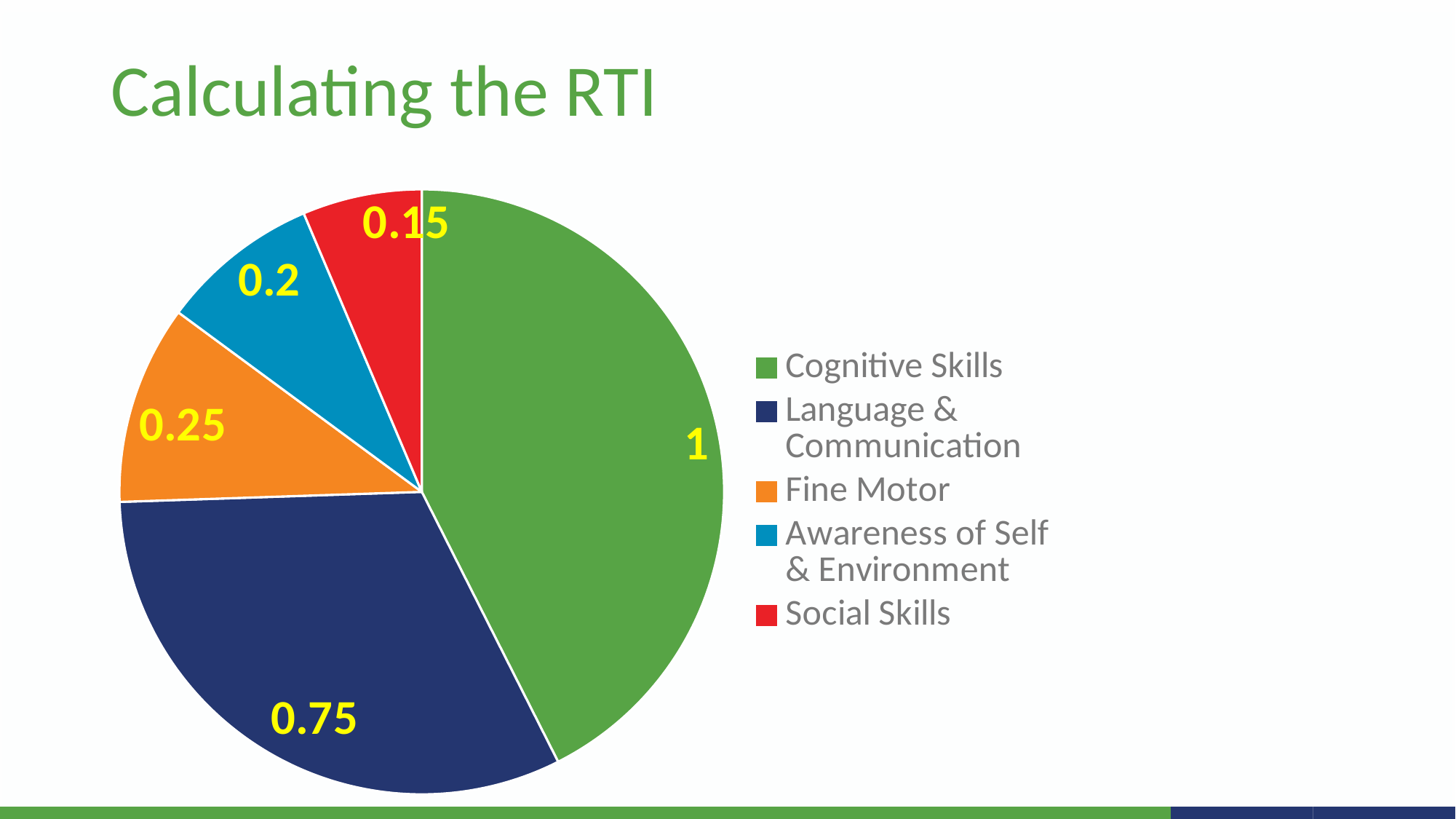
What is the value for Awareness of Self & Environment? 0.2 What is the value for Language & Communication? 0.75 What type of chart is shown on the slide? pie chart What is the value for Cognitive Skills? 1 What is the value for Fine Motor? 0.25 Which category has the largest slice? Cognitive Skills What is the difference between the values for Cognitive Skills and Language & Communication? 0.25 What is the value for Social Skills? 0.15 How many categories does the pie chart have? 5 Which category has the smallest slice? Social Skills Which is larger, the value for Fine Motor or the value for Awareness of Self & Environment? Fine Motor What colour is the slice for Language & Communication? dark blue